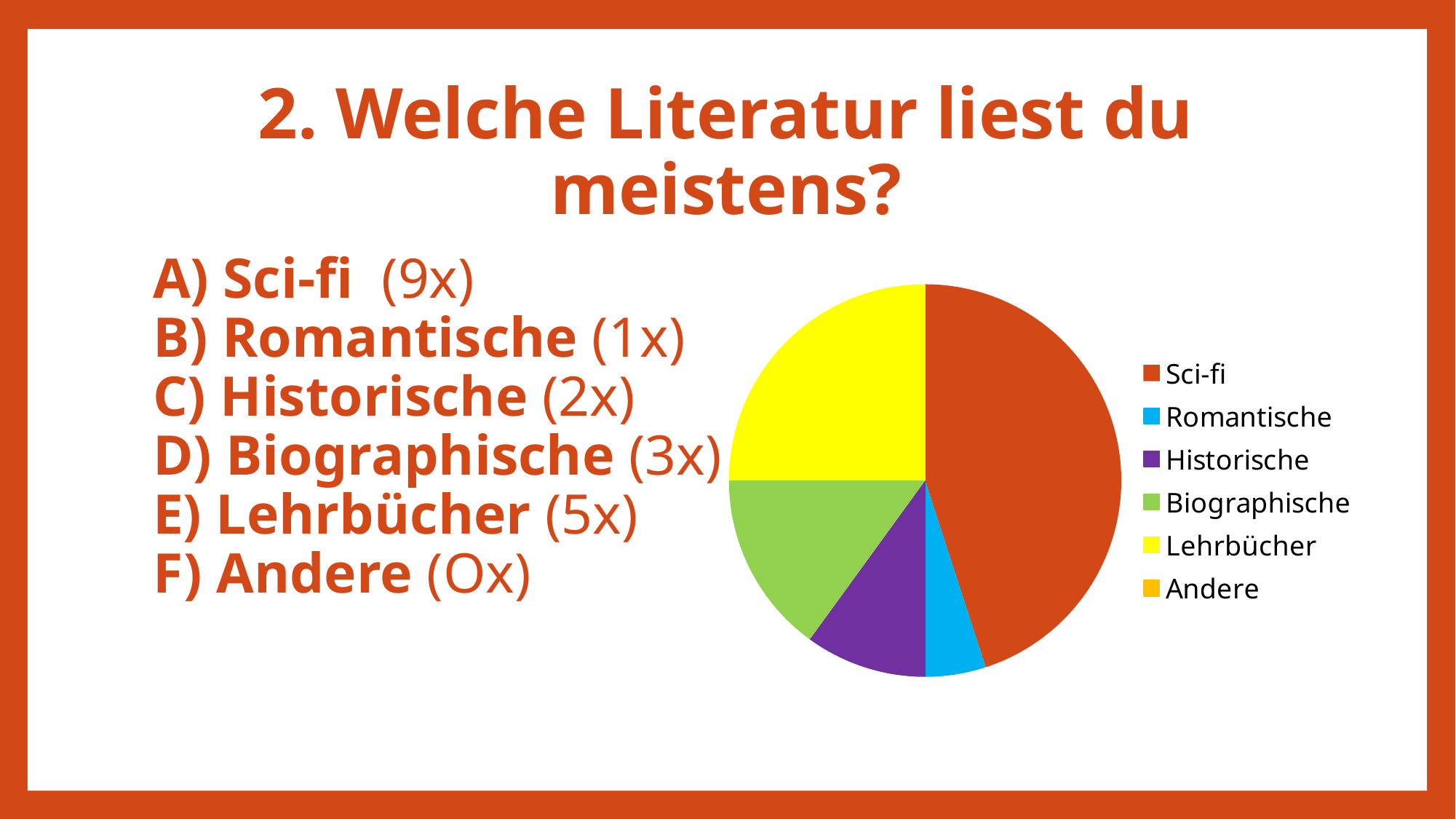
What is the difference between the counts for Sci-fi and Lehrbücher? 4 How many times was Biographische chosen according to the slide? 3x What kind of chart is shown on the slide? pie chart How many entries does the legend of the pie chart list? 6 What colour is the Lehrbücher slice in the pie chart? yellow What share of the pie does Lehrbücher represent? 25% Which category has the largest slice of the pie chart? Sci-fi Which slice is larger, Historische or Biographische? Biographische How many times was Sci-fi chosen according to the slide? 9x How many times was Lehrbücher chosen according to the slide? 5x What share of the pie does Sci-fi represent? 45%